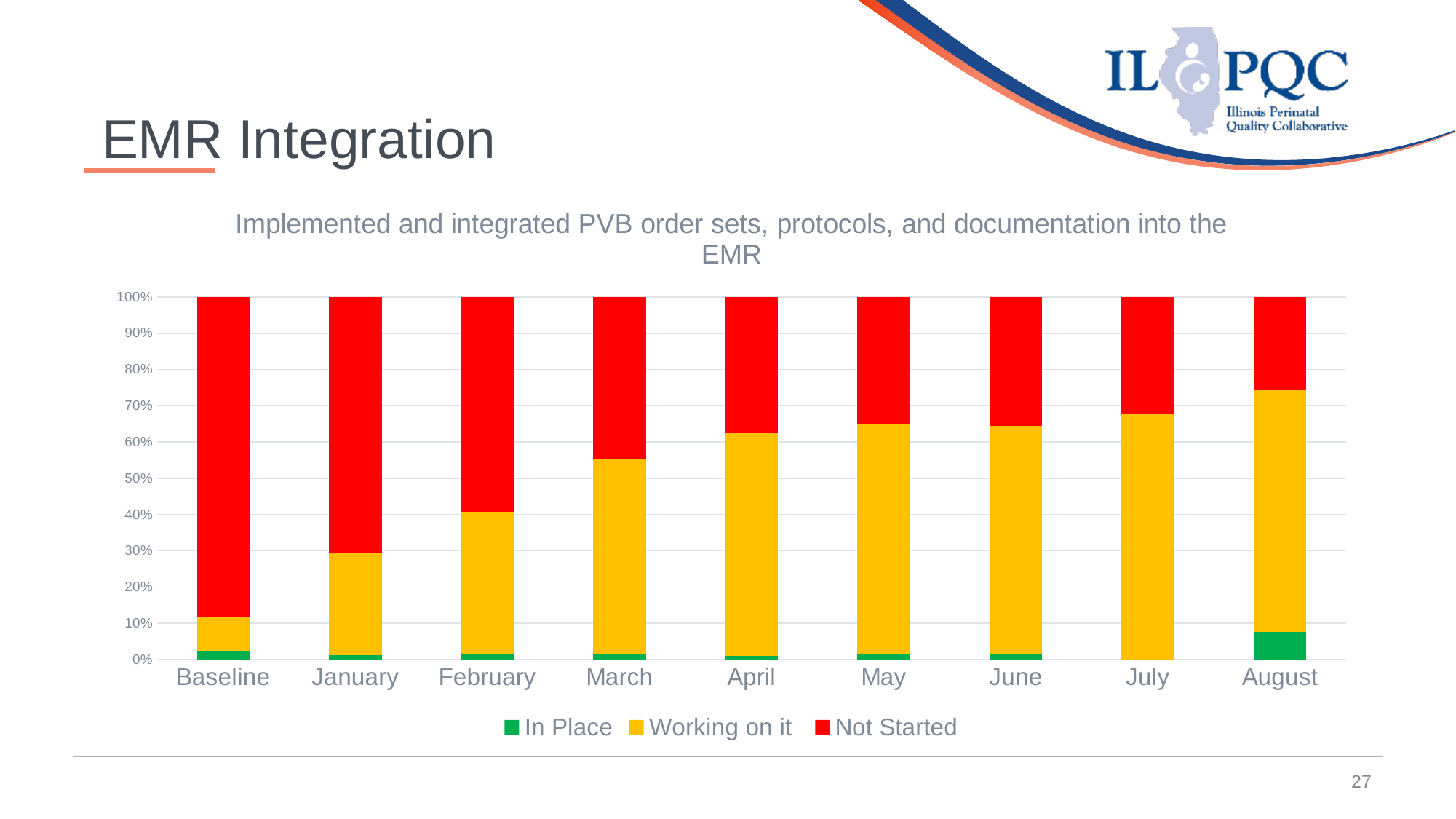
Is the 'Not Started' value for August greater or less than 30%? less How many series does the chart's legend list? 3 Which category has the largest 'In Place' segment? August What kind of chart is shown on the slide? Stacked bar chart Which category has the smallest 'Working on it' segment? Baseline Which colour represents the 'Not Started' series in the legend? Red Is the 'Working on it' value for March greater or less than 50%? greater Is the 'Not Started' value for Baseline greater or less than 80%? greater Which category has the largest 'Not Started' segment? Baseline Does the 'Not Started' share rise or fall from Baseline to August? Fall How many categories are shown along the x axis of the chart? 9 Which is larger, the 'Not Started' segment for January or for March? January